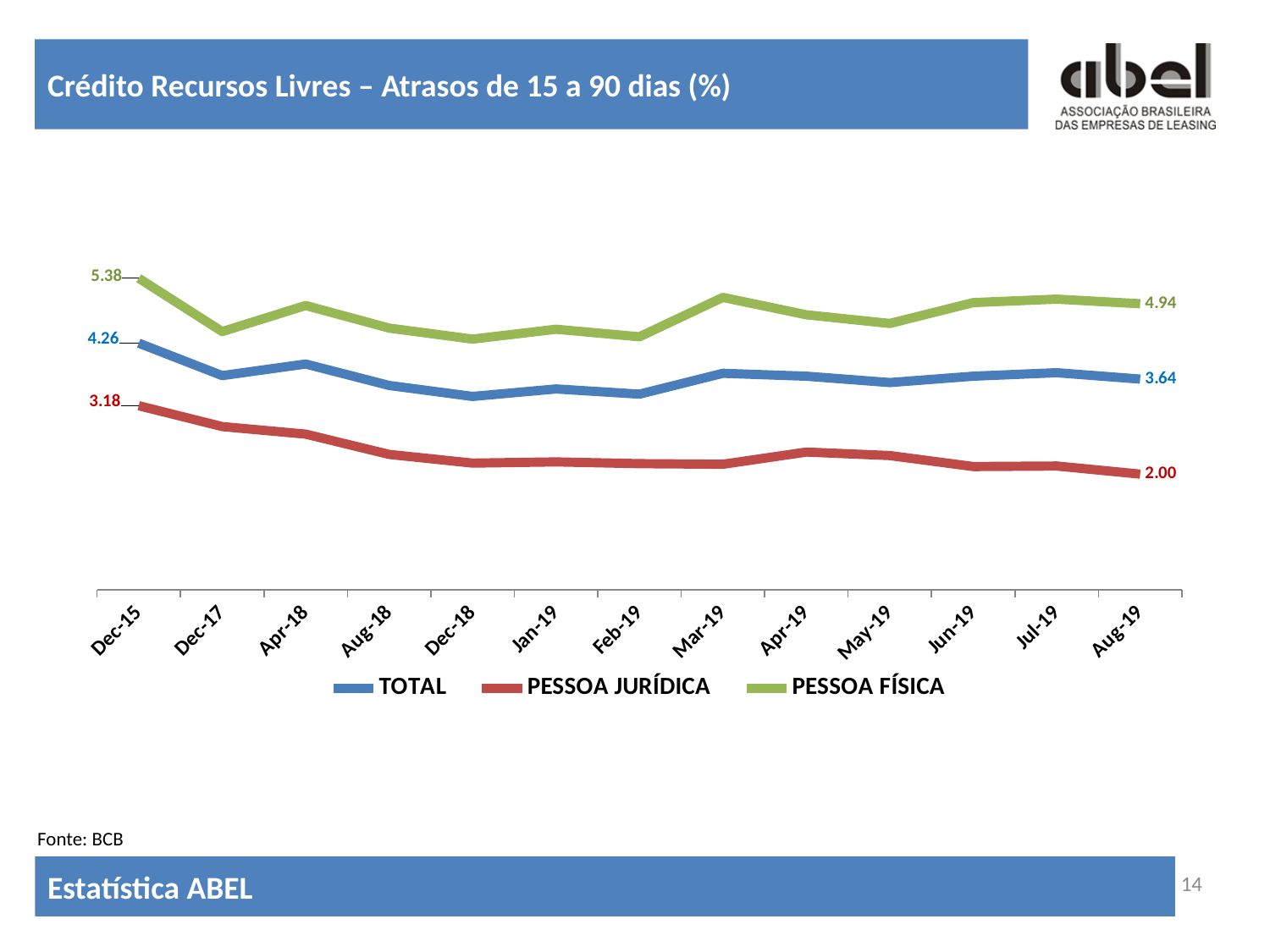
How many time points are shown on the x axis? 13 Which series has the lowest value at Dec-15? PESSOA JURÍDICA Which series has the highest value at Aug-19? PESSOA FÍSICA What is the difference between the PESSOA JURÍDICA value at Dec-15 and at Aug-19? 1.18 What is the value of TOTAL at Aug-19? 3.64 How many series does the legend list? 3 What is the value of PESSOA FÍSICA at Dec-15? 5.38 What type of chart is shown on the slide? Line chart What is the value of PESSOA JURÍDICA at Dec-15? 3.18 Does the PESSOA JURÍDICA series rise or fall from Dec-15 to Aug-19? Fall What is the value of PESSOA JURÍDICA at Aug-19? 2.00 What is the title of the chart? Crédito Recursos Livres – Atrasos de 15 a 90 dias (%)